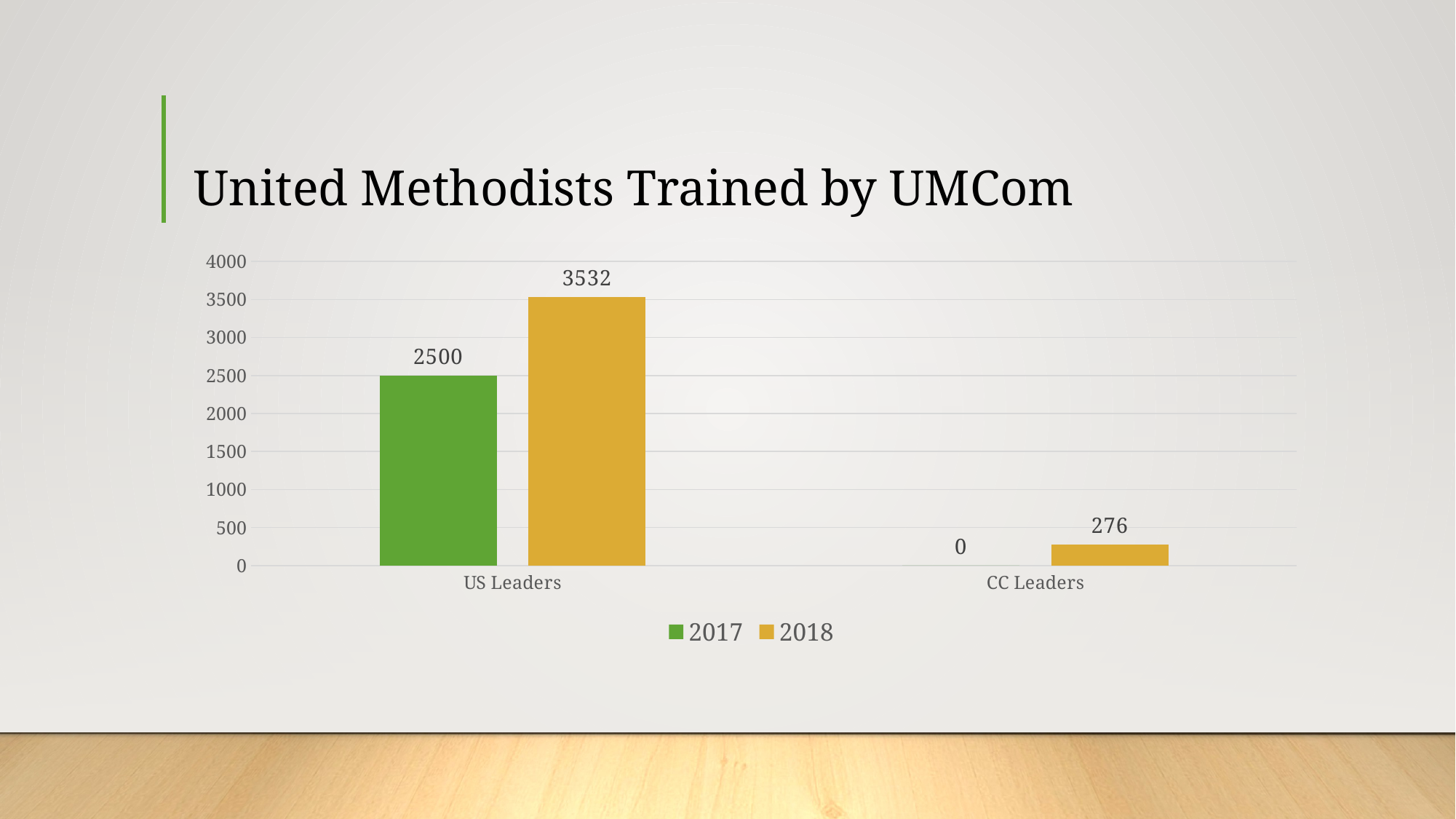
Which category has the highest value in the 2018 series? US Leaders What is the title of the chart? United Methodists Trained by UMCom What is the difference between the 2018 and 2017 values for US Leaders? 1032 What is the value for US Leaders in 2017? 2500 Which is larger for US Leaders: the 2017 value or the 2018 value? 2018 How many series does the legend list? 2 Which category has the lowest value in the 2017 series? CC Leaders What is the value for US Leaders in 2018? 3532 What is the value for CC Leaders in 2017? 0 What kind of chart is shown on the slide? Bar chart How many categories are shown on the x axis? 2 What is the value for CC Leaders in 2018? 276